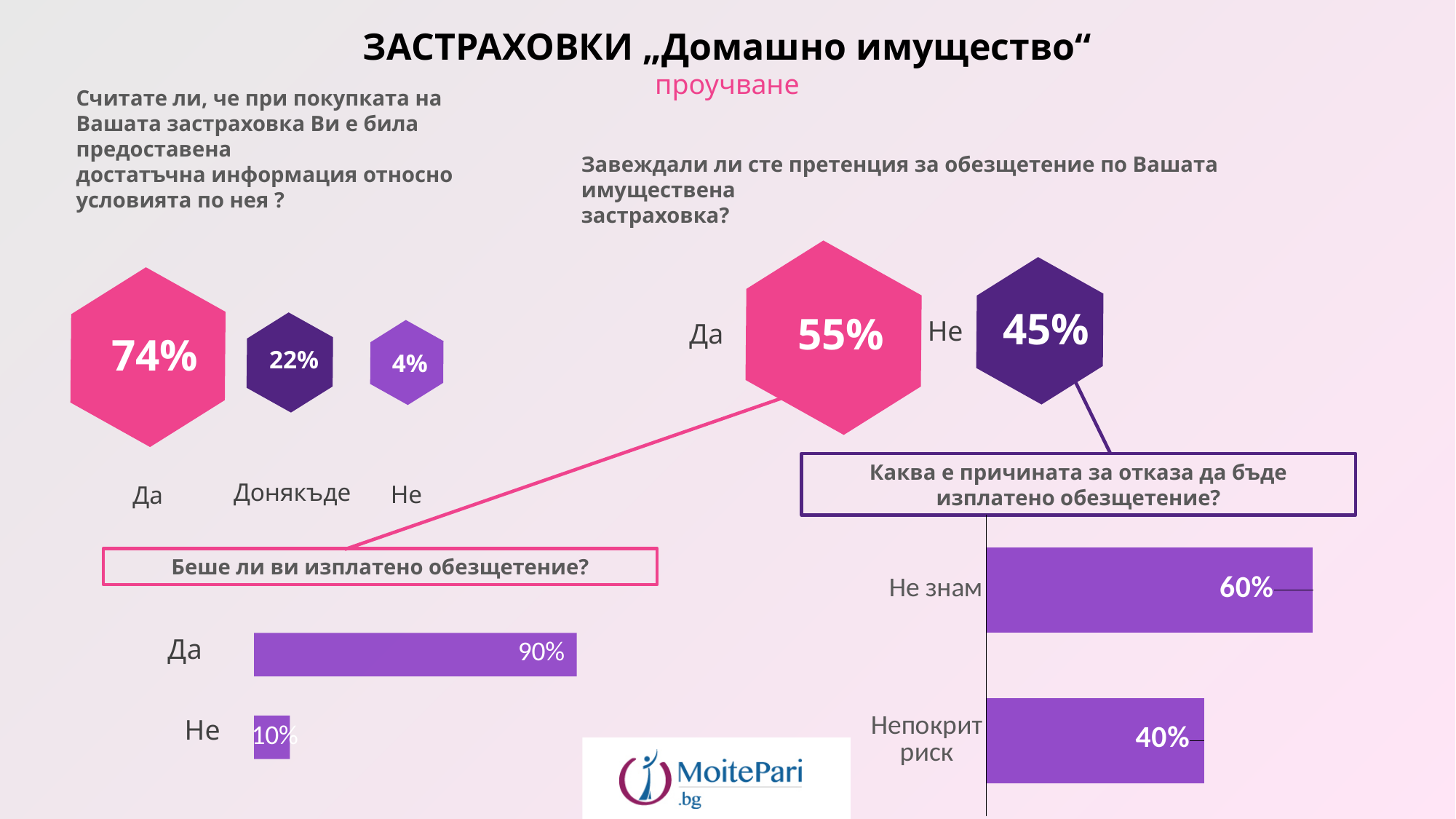
In the chart "Беше ли ви изплатено обезщетение?", what is the difference between the values for "Да" and "Не"? 80% In the chart "Каква е причината за отказа да бъде изплатено обезщетение?", what is the value for "Непокрит риск"? 40% In the chart "Каква е причината за отказа да бъде изплатено обезщетение?", what is the difference between "Не знам" and "Непокрит риск"? 20% In the chart "Каква е причината за отказа да бъде изплатено обезщетение?", which is larger, "Не знам" or "Непокрит риск"? Не знам In the chart "Беше ли ви изплатено обезщетение?", how many categories are shown? 2 In the chart "Беше ли ви изплатено обезщетение?", what is the value for "Не"? 10% In the chart "Каква е причината за отказа да бъде изплатено обезщетение?", what is the value for "Не знам"? 60% What colour are the bars in the chart "Каква е причината за отказа да бъде изплатено обезщетение?"? purple In the chart "Беше ли ви изплатено обезщетение?", what is the value for "Да"? 90% In the chart "Каква е причината за отказа да бъде изплатено обезщетение?", which category has the lowest value? Непокрит риск In the chart "Беше ли ви изплатено обезщетение?", which category has the highest value? Да What kind of chart is "Беше ли ви изплатено обезщетение?"? bar chart